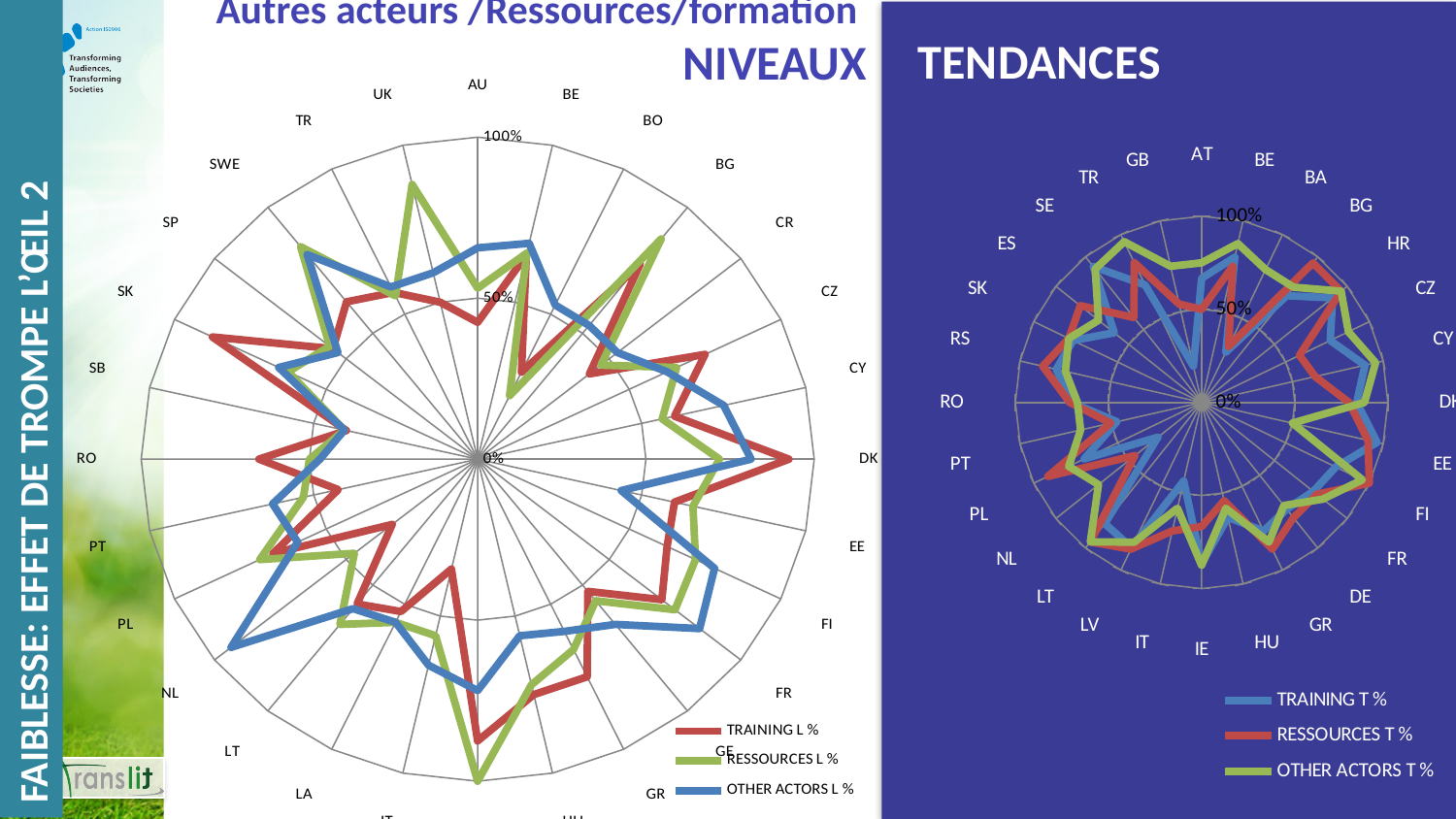
In the NIVEAUX chart, is the TRAINING L % value for DK greater or less than 50%? greater In the TENDANCES chart, is the RESSOURCES T % value for RS greater or less than 50%? greater What kind of chart is the NIVEAUX chart on the left? radar chart What kind of chart is the TENDANCES chart on the right? radar chart How many series does the legend of the NIVEAUX chart list? 3 In the NIVEAUX chart, is the TRAINING L % value for PL greater or less than 50%? greater In the TENDANCES chart, which series has the larger value for RS: RESSOURCES T % or TRAINING T %? RESSOURCES T % In the NIVEAUX chart, which series has the larger value for SK: TRAINING L % or OTHER ACTORS L %? TRAINING L % How many series does the legend of the TENDANCES chart list? 3 What are the three legend entries of the TENDANCES chart? TRAINING T %, RESSOURCES T %, OTHER ACTORS T %